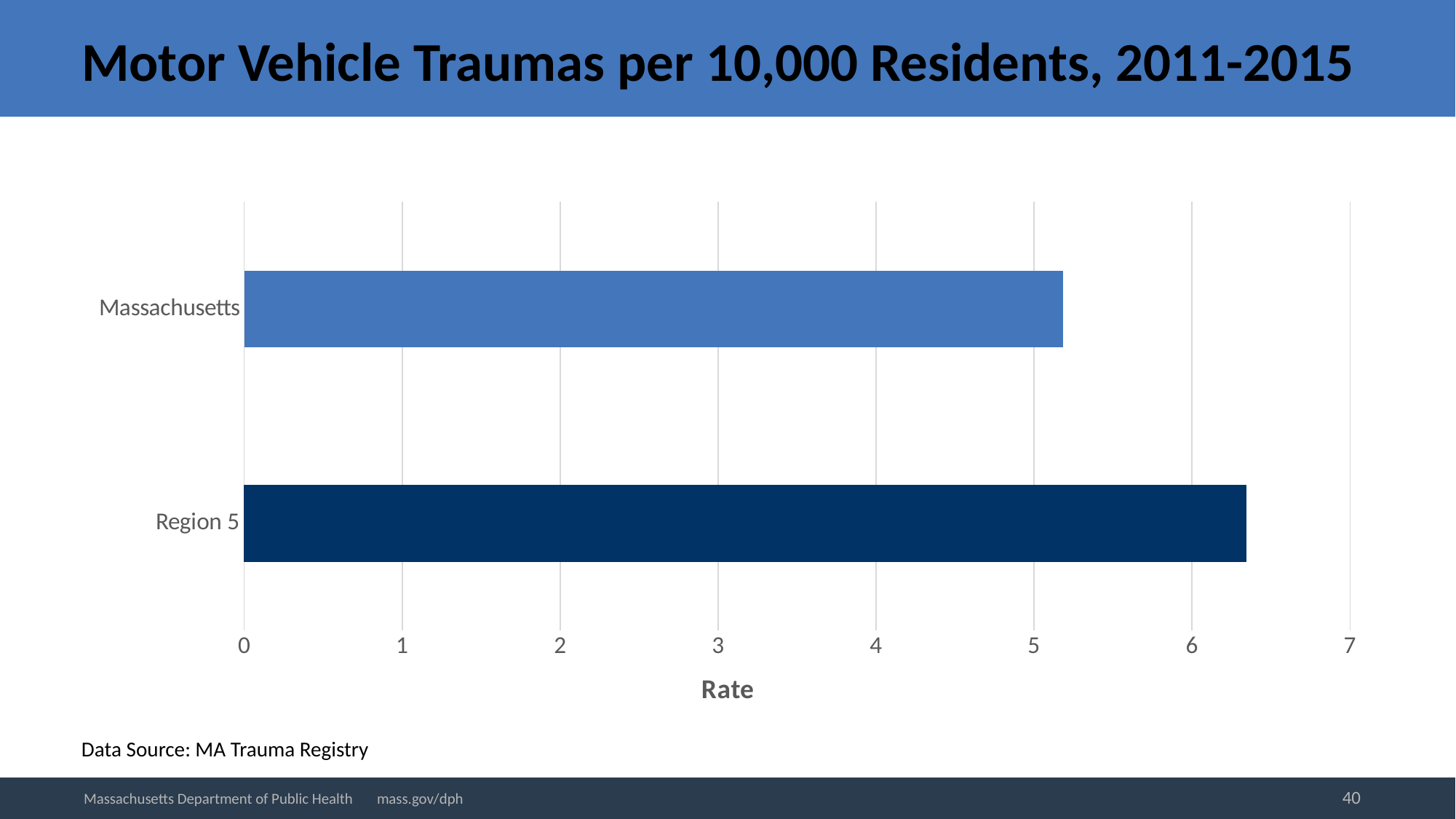
How many categories are plotted in the chart? 2 Is the rate for Region 5 larger or smaller than the rate for Massachusetts? larger Which category has the highest motor vehicle trauma rate? Region 5 Is the value for Region 5 greater or less than 7? less Is the value for Massachusetts greater or less than 5? greater Is the value for Massachusetts greater or less than 6? less What is the label of the horizontal axis? Rate What is the title of the chart? Motor Vehicle Traumas per 10,000 Residents, 2011-2015 What kind of chart is shown on the slide? bar chart Which category has the lowest motor vehicle trauma rate? Massachusetts